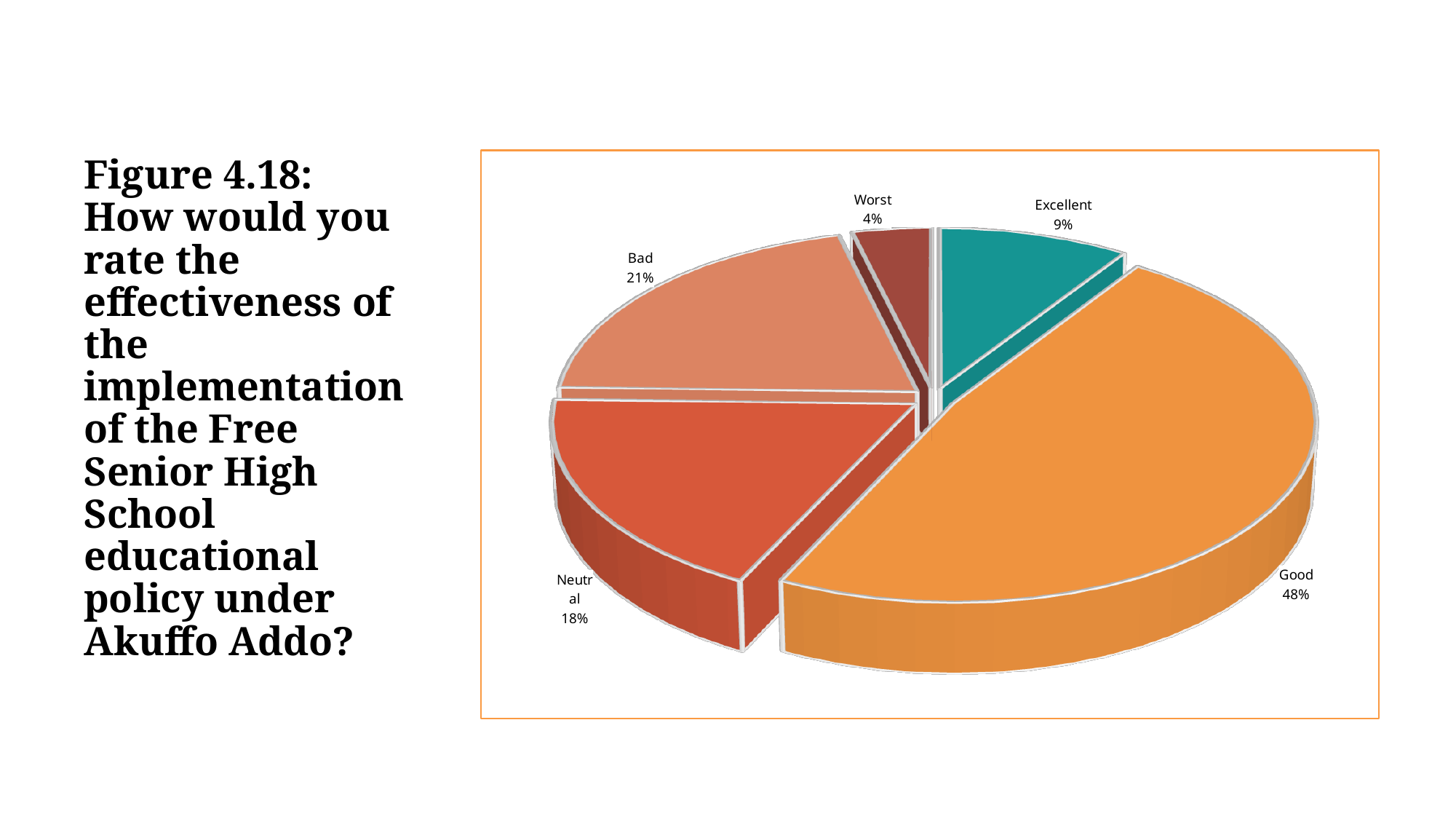
What is the difference in percentage points between the Bad and Neutral slices? 3 What percentage of respondents rated the policy as Worst? 4% Which rating category has the smallest share of the pie? Worst What is the figure number given in the slide title? Figure 4.18 What percentage of respondents rated the policy as Good? 48% What type of chart is shown on the slide? pie chart Which is larger, the Excellent slice or the Worst slice? Excellent How many categories are shown in the pie chart? 5 What percentage of respondents rated the policy as Bad? 21% What percentage of respondents rated the policy as Excellent? 9% What percentage of respondents rated the policy as Neutral? 18% Which rating category has the largest share of the pie? Good